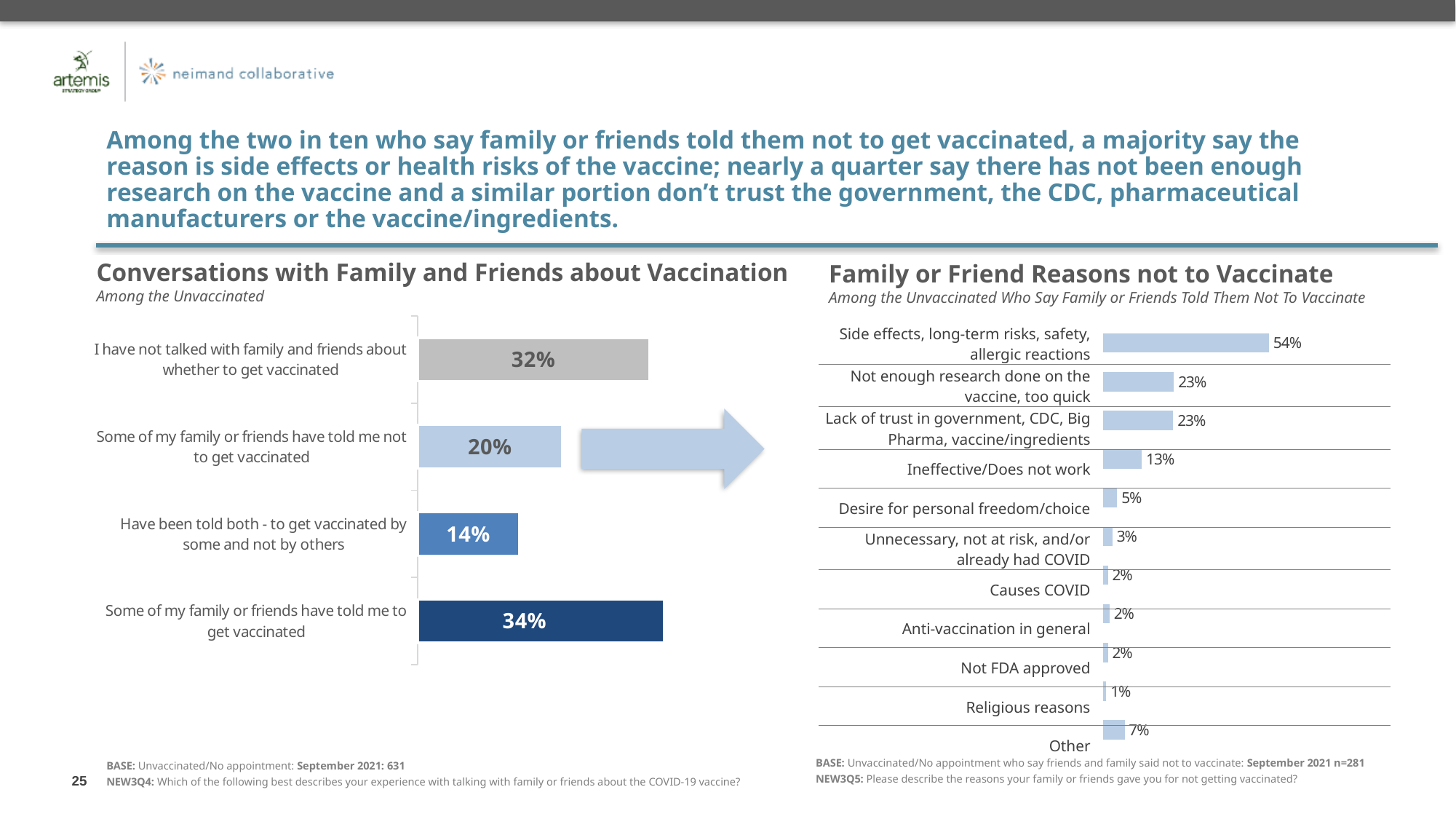
In the 'Conversations with Family and Friends about Vaccination' chart, what percentage say some of their family or friends have told them not to get vaccinated? 20% In the 'Conversations with Family and Friends about Vaccination' chart, which category has the highest value? Some of my family or friends have told me to get vaccinated In the 'Family or Friend Reasons not to Vaccinate' chart, which is larger: Desire for personal freedom/choice or Other? Other In the 'Family or Friend Reasons not to Vaccinate' chart, what percentage cite Ineffective/Does not work? 13% In the 'Family or Friend Reasons not to Vaccinate' chart, how many reasons are listed? 11 In the 'Conversations with Family and Friends about Vaccination' chart, which category has the lowest value? Have been told both - to get vaccinated by some and not by others In the 'Conversations with Family and Friends about Vaccination' chart, what is the difference between the share told to get vaccinated and the share told not to get vaccinated? 14 percentage points In the 'Conversations with Family and Friends about Vaccination' chart, what percentage have not talked with family and friends about whether to get vaccinated? 32% In the 'Family or Friend Reasons not to Vaccinate' chart, which reason has the lowest value? Religious reasons In the 'Family or Friend Reasons not to Vaccinate' chart, what percentage cite side effects, long-term risks, safety, allergic reactions? 54% What type of chart is the 'Family or Friend Reasons not to Vaccinate' chart? Bar chart In the 'Conversations with Family and Friends about Vaccination' chart, how many categories are shown? 4